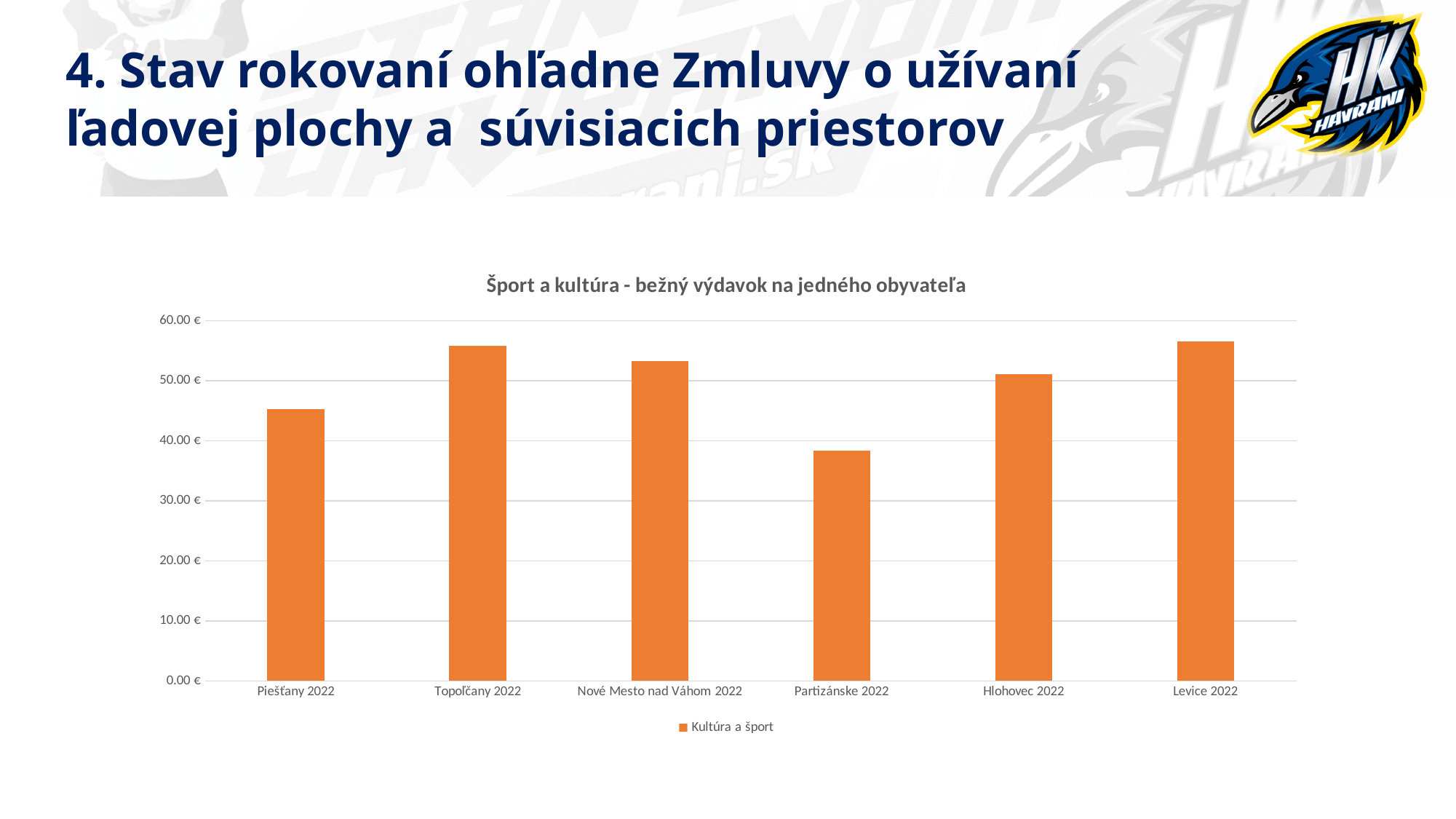
Which category has the lowest value in the chart? Partizánske 2022 How many series does the chart legend list? 1 What kind of chart is shown on the slide? bar chart Which is larger, the value for Piešťany 2022 or the value for Partizánske 2022? Piešťany 2022 What is the title of the chart? Šport a kultúra - bežný výdavok na jedného obyvateľa Which is larger, the value for Topoľčany 2022 or the value for Hlohovec 2022? Topoľčany 2022 Is the value for Topoľčany 2022 greater or less than 50.00 €? greater Is the value for Piešťany 2022 greater or less than 40.00 €? greater Is the value for Piešťany 2022 greater or less than 50.00 €? less How many categories are shown on the x axis of the chart? 6